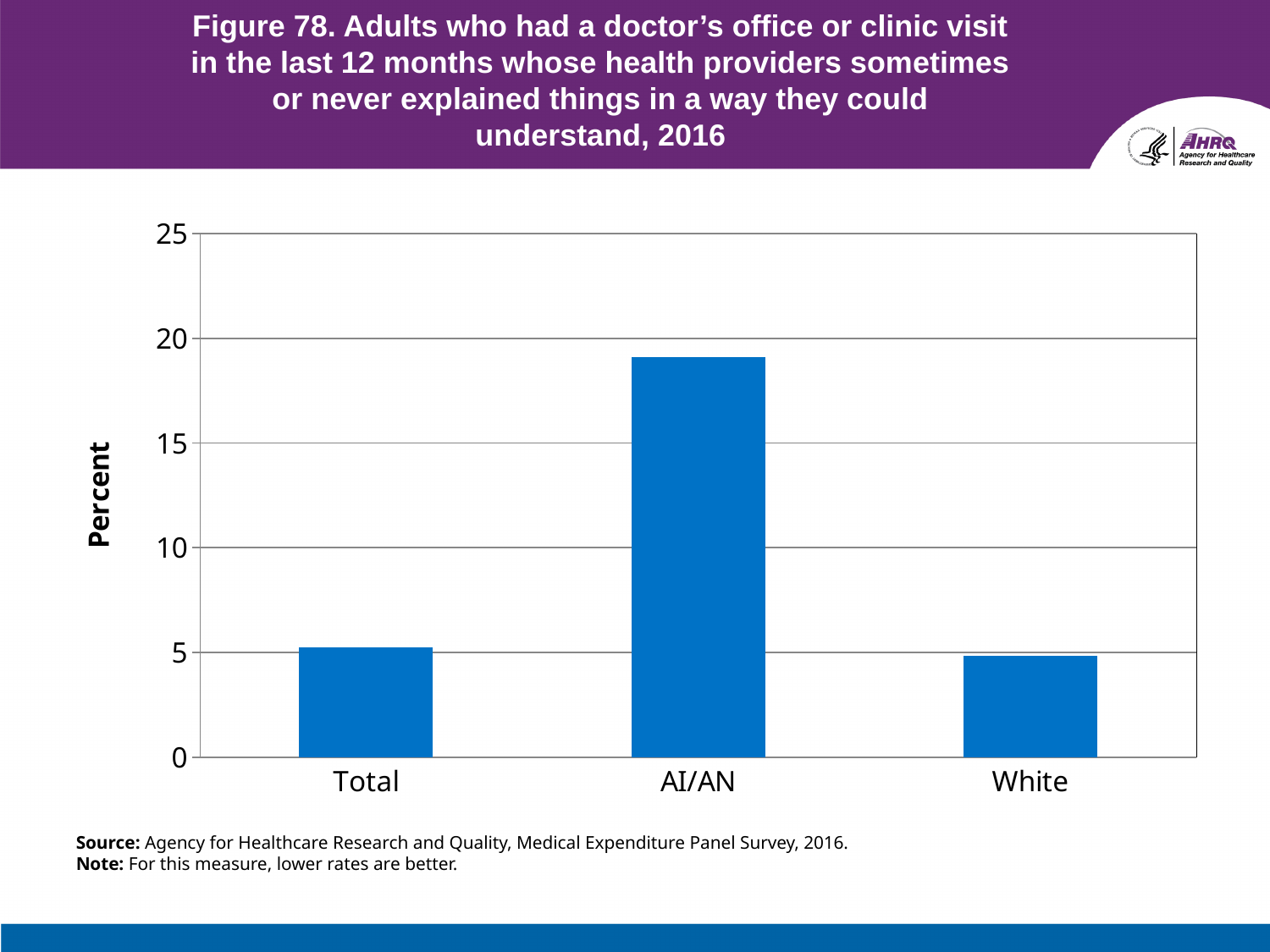
What is the maximum value shown on the y axis of the chart? 25 What is the label on the y axis of the chart? Percent Is the value for AI/AN greater or less than 20? less Is the value for Total greater or less than 10? less Is the value for AI/AN greater or less than 15? greater How many categories are shown on the x axis of the chart? 3 What kind of chart is shown on the slide? bar chart Which is larger, the value for AI/AN or the value for Total? AI/AN Which category has the highest value in the chart? AI/AN Which is larger, the value for AI/AN or the value for White? AI/AN